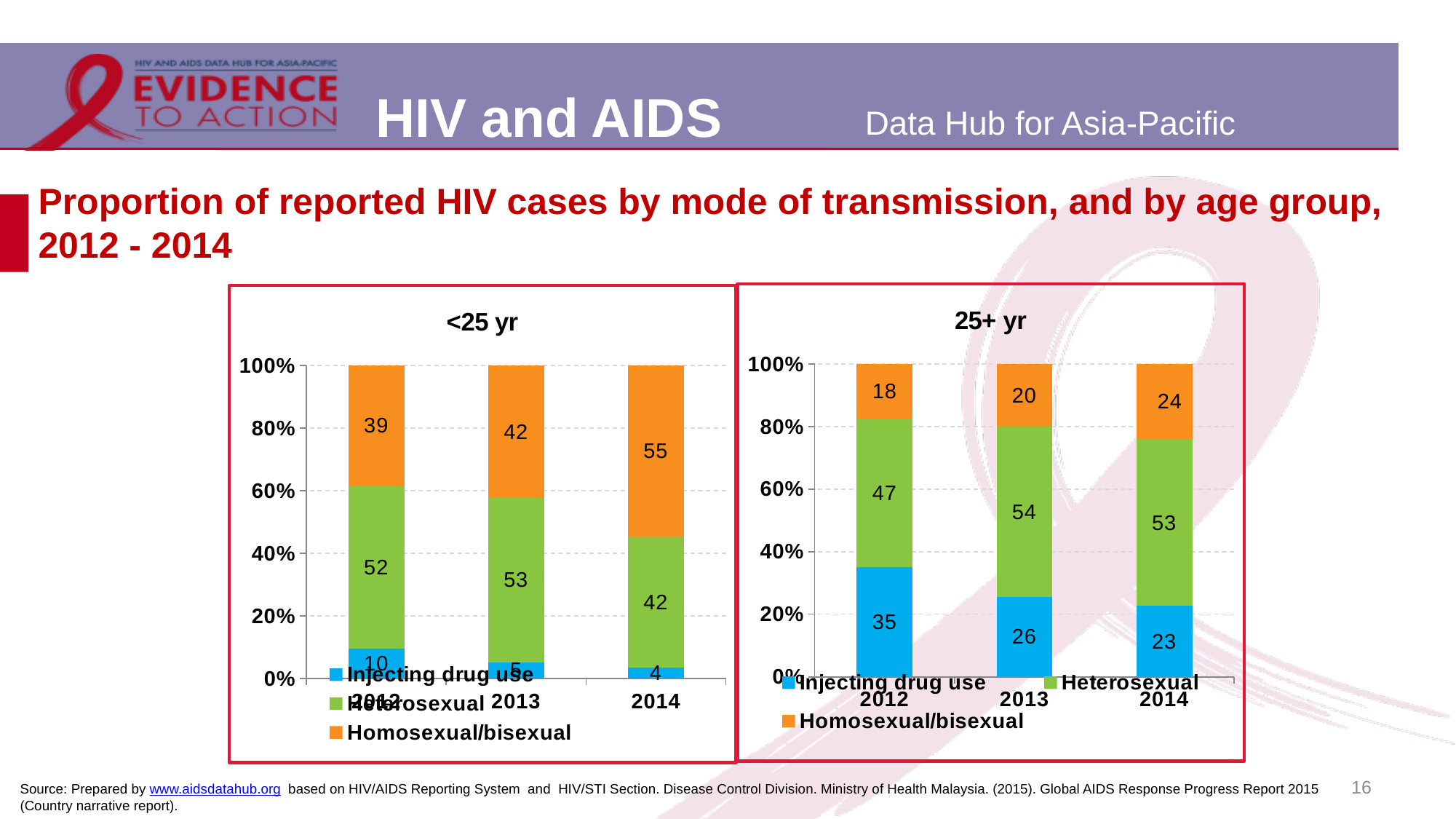
What kind of chart is the "<25 yr" chart? Stacked bar chart How many years are shown on the x axis of the "<25 yr" chart? 3 In the "25+ yr" chart, how does the Injecting drug use value change from 2012 to 2014? It falls In the "<25 yr" chart, which year has the lowest value for Injecting drug use? 2014 In the "<25 yr" chart, which is larger in 2012: the Heterosexual value or the Homosexual/bisexual value? Heterosexual How many series does the legend of the "25+ yr" chart list? 3 In the "25+ yr" chart, which colour represents Heterosexual? Green In the "25+ yr" chart, which year has the highest value for Homosexual/bisexual? 2014 In the "25+ yr" chart, what is the difference between the Heterosexual values for 2013 and 2012? 7 In the "<25 yr" chart, what is the value for Heterosexual in 2013? 53 In the "25+ yr" chart, what is the value for Injecting drug use in 2012? 35 In the "<25 yr" chart, what is the value for Homosexual/bisexual in 2014? 55